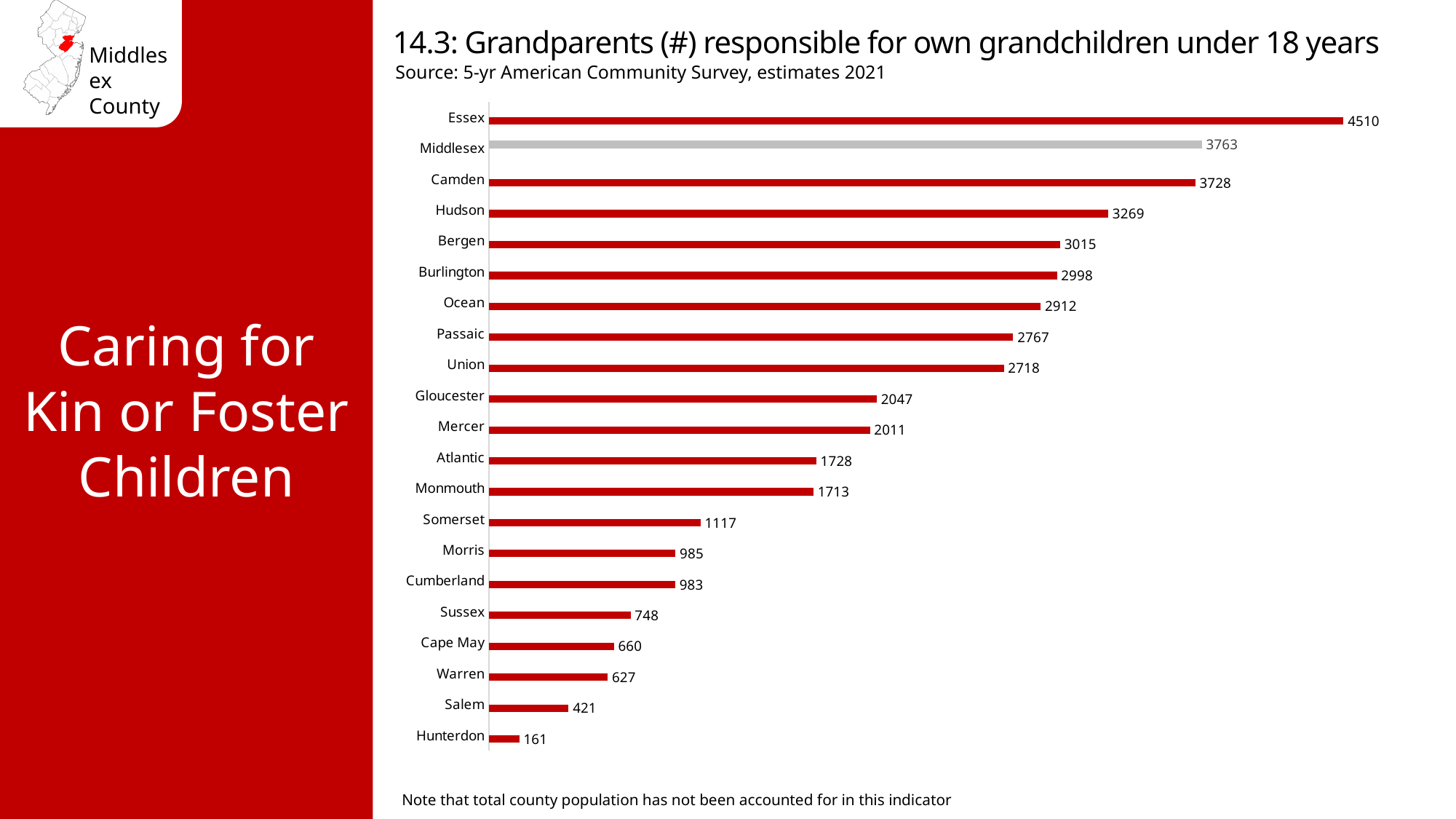
Which has a larger value, Bergen or Burlington? Bergen What type of chart is shown on the slide? Bar chart Which has a larger value, Salem or Warren? Warren What is the difference between the values for Gloucester and Mercer? 36 Which county's bar is shown in grey rather than red? Middlesex Which county has the lowest value on the chart? Hunterdon What is the value shown for Hudson? 3269 What is the number of grandparents responsible for own grandchildren in Middlesex? 3763 What is the value shown for Cape May? 660 What is the difference between the values for Essex and Middlesex? 747 How many counties are shown on the chart? 21 Which county has the highest number of grandparents responsible for own grandchildren? Essex